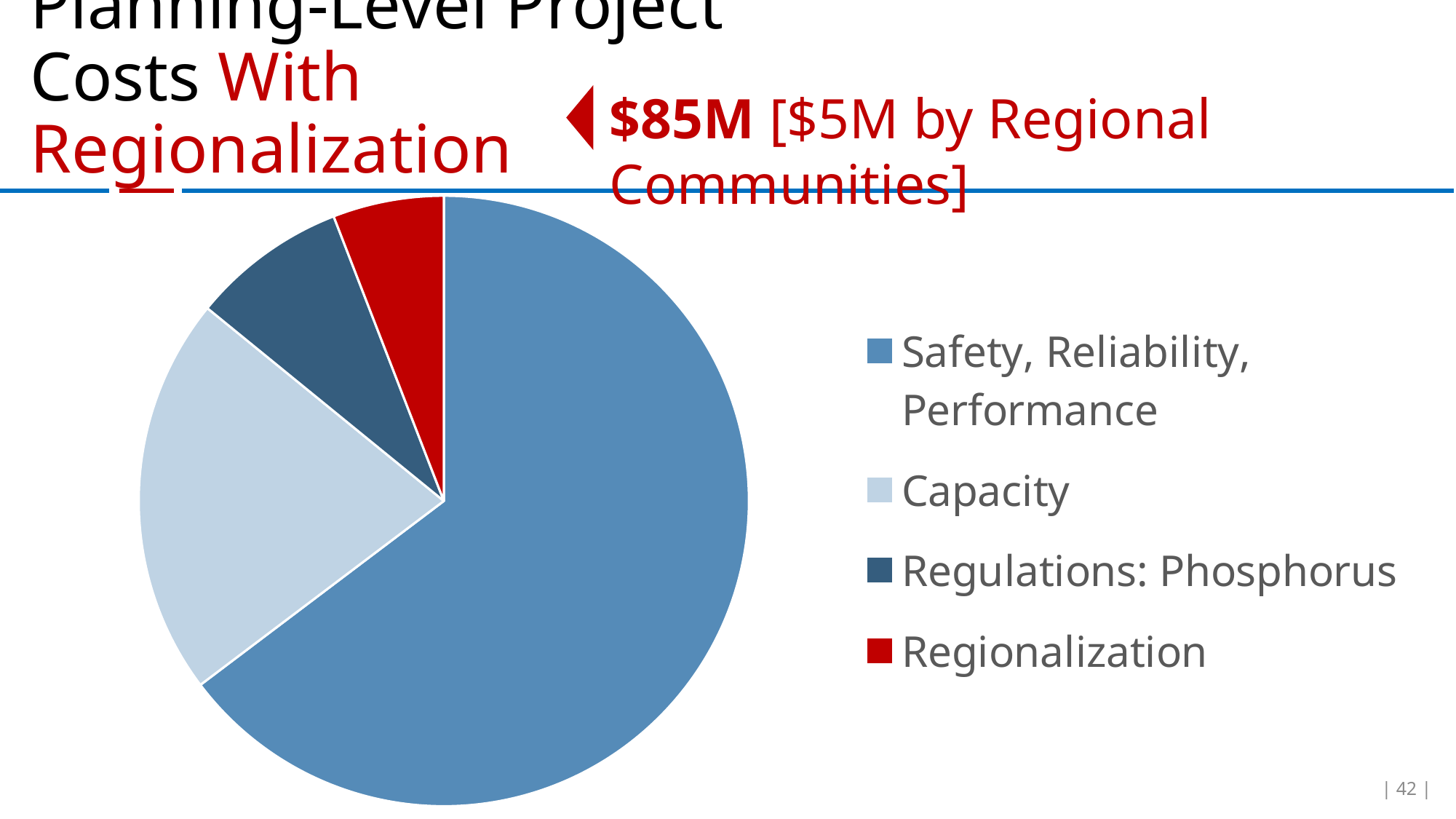
Which category has the largest slice of the pie chart? Safety, Reliability, Performance Which category has the smallest slice of the pie chart? Regionalization Which slice is larger, Safety, Reliability, Performance or Capacity? Safety, Reliability, Performance What kind of chart is shown on the slide? pie chart How many entries does the legend of the pie chart list? 4 Which slice is larger, Capacity or Regionalization? Capacity Does the Safety, Reliability, Performance slice make up more or less than half of the pie? more Which legend entry is shown in the lightest blue colour? Capacity How many slices does the pie chart have? 4 Which slice is larger, Capacity or Regulations: Phosphorus? Capacity What colour is the Regionalization slice in the pie chart? red